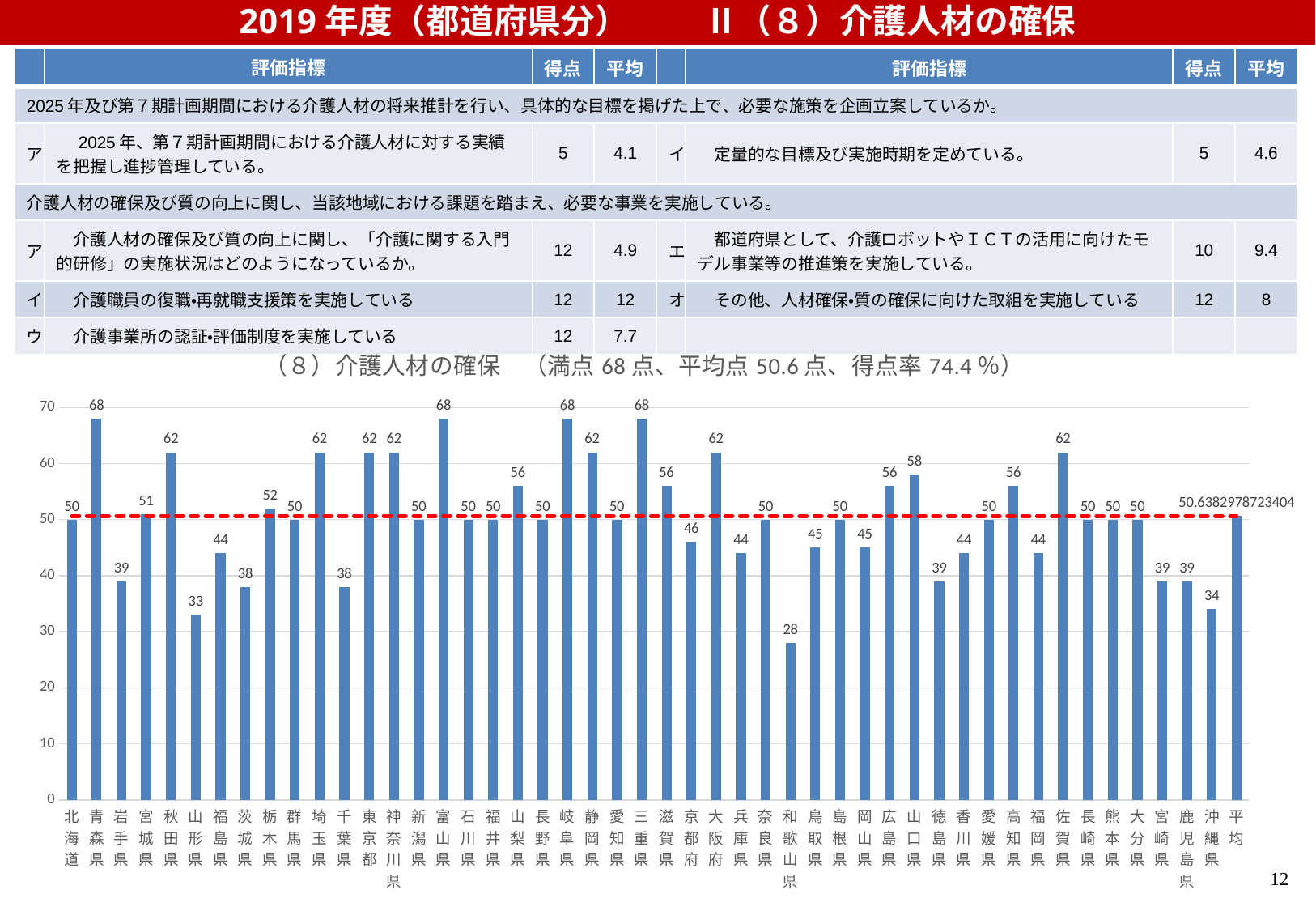
Which has a larger value, 京都府 or 大阪府? 大阪府 What is the difference between the values for 山形県 and 沖縄県? 1 Which has a larger value, 鳥取県 or 広島県? 広島県 Which prefecture has the lowest value in the bar chart? 和歌山県 What is the value for 栃木県 in the bar chart? 52 What is the value for 山口県 in the bar chart? 58 What kind of chart is shown on the slide? bar chart What is the difference between the values for 青森県 and 岩手県? 29 Is the value for 千葉県 greater or less than 40? less What is the value for 和歌山県 in the bar chart? 28 What value is labeled on the red dashed horizontal line in the chart? 50.6382978723404 What is the highest value shown in the bar chart? 68